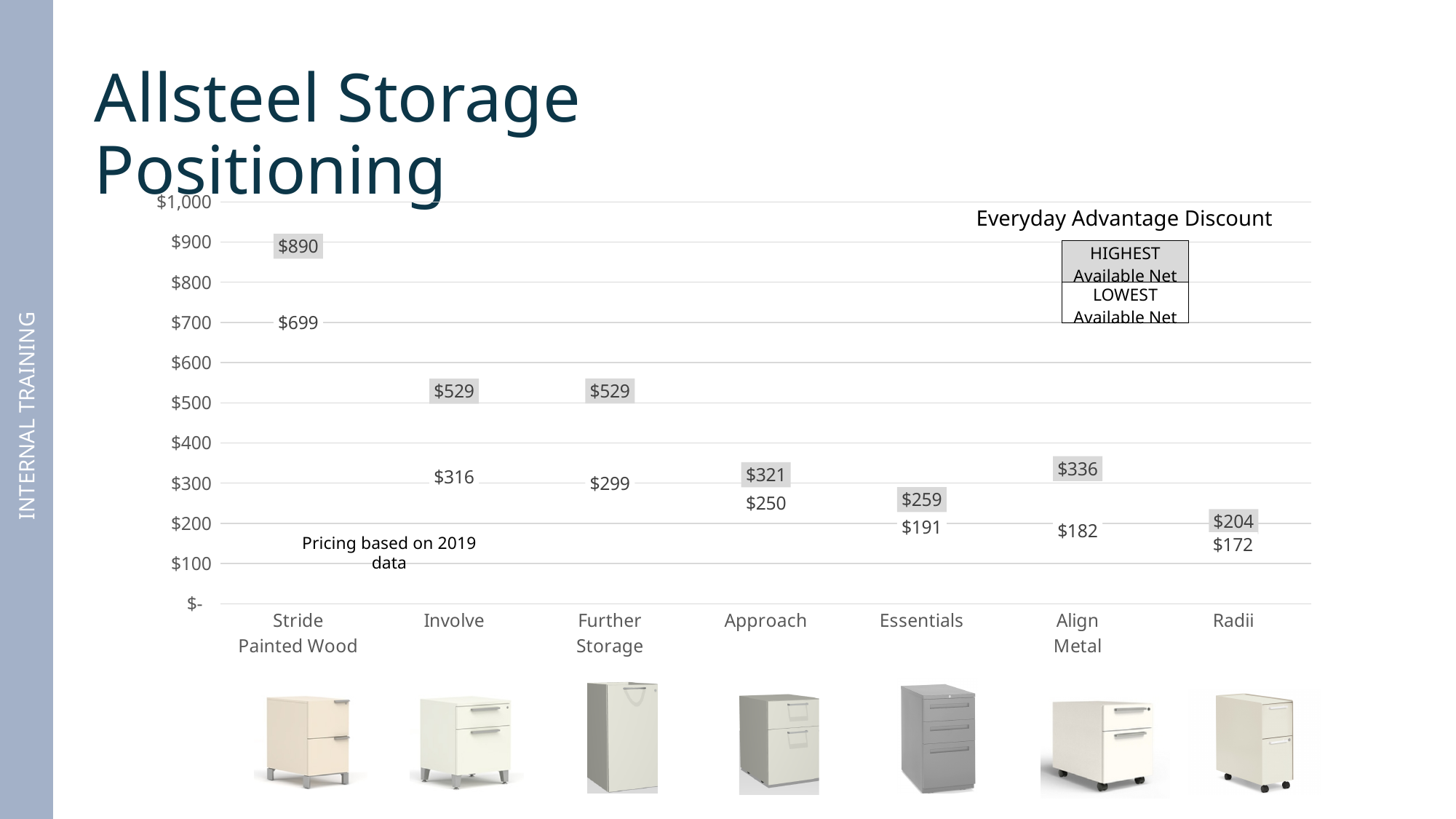
How many series does the legend list? 2 Which product has the highest HIGHEST Available Net value? Stride Painted Wood What is the HIGHEST Available Net value for Align Metal? $336 What is the LOWEST Available Net value for Further Storage? $299 Which product has the lowest LOWEST Available Net value? Radii What is the title of the legend box on the chart? Everyday Advantage Discount What is the difference between the HIGHEST Available Net values for Approach and Essentials? $62 Which is larger, the LOWEST Available Net value for Approach or for Essentials? Approach How many products are shown on the x axis? 7 What is the difference between the HIGHEST and LOWEST Available Net values for Involve? $213 What is the LOWEST Available Net value for Radii? $172 What is the HIGHEST Available Net value for Stride Painted Wood? $890